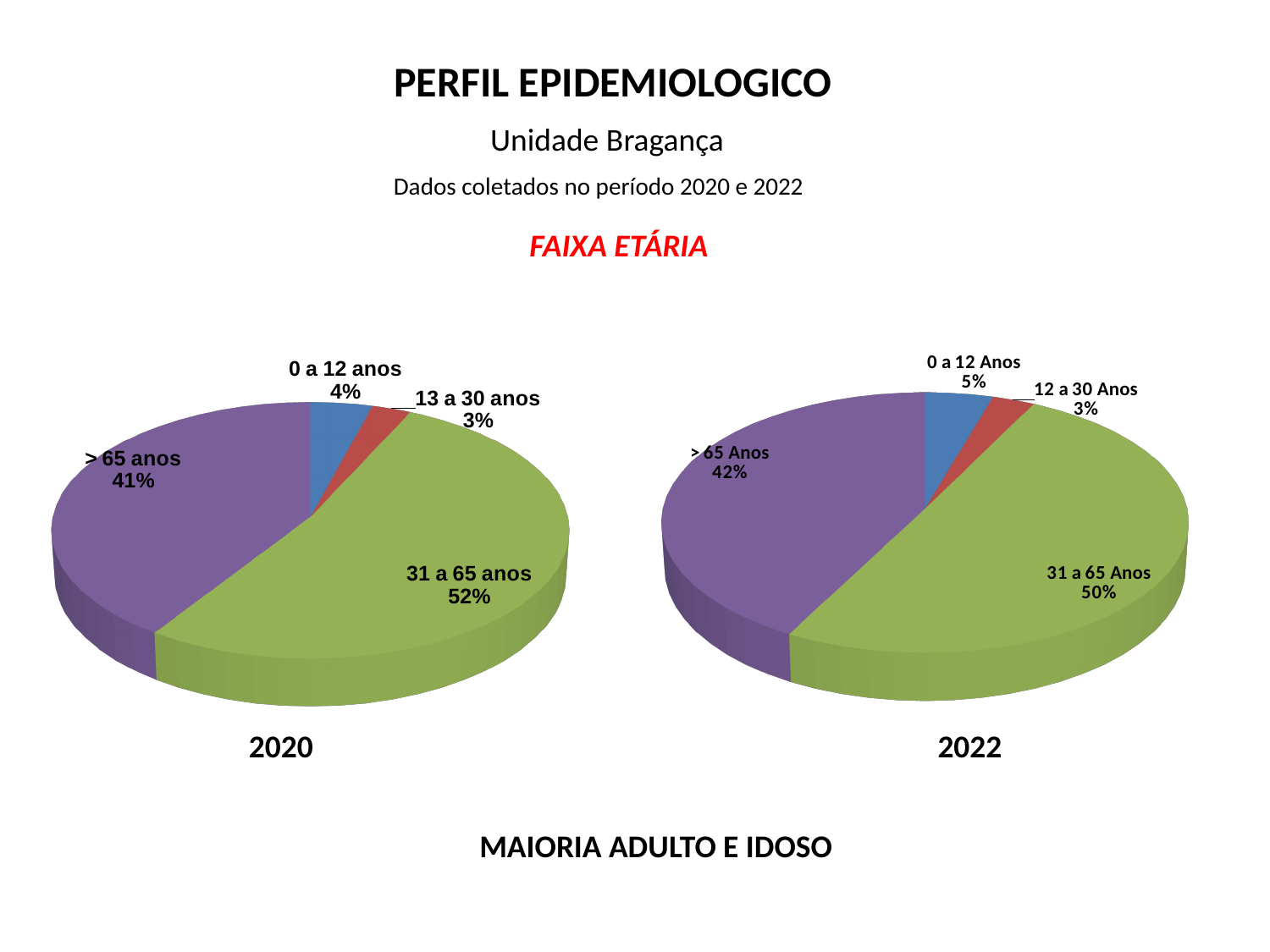
In the 2022 pie chart, what share is labelled for 12 a 30 Anos? 3% What kind of chart is the 2022 chart? Pie chart In the 2022 pie chart, which age group has the smallest share? 12 a 30 Anos In the 2020 pie chart, which age group has the largest share? 31 a 65 anos In the 2020 pie chart, what share is labelled for 0 a 12 anos? 4% Which is larger: the share for 0 a 12 anos in the 2020 chart or the share for 0 a 12 Anos in the 2022 chart? 2022 (5%) What colour is the 31 a 65 anos slice in the 2020 pie chart? Green How many slices does the 2020 pie chart have? 4 In the 2020 pie chart, what share is labelled for 31 a 65 anos? 52% In the 2022 pie chart, what is the difference between the shares for 0 a 12 Anos and 12 a 30 Anos? 2% In the 2020 pie chart, what is the difference between the shares for 31 a 65 anos and > 65 anos? 11% In the 2022 pie chart, what share is labelled for > 65 Anos? 42%